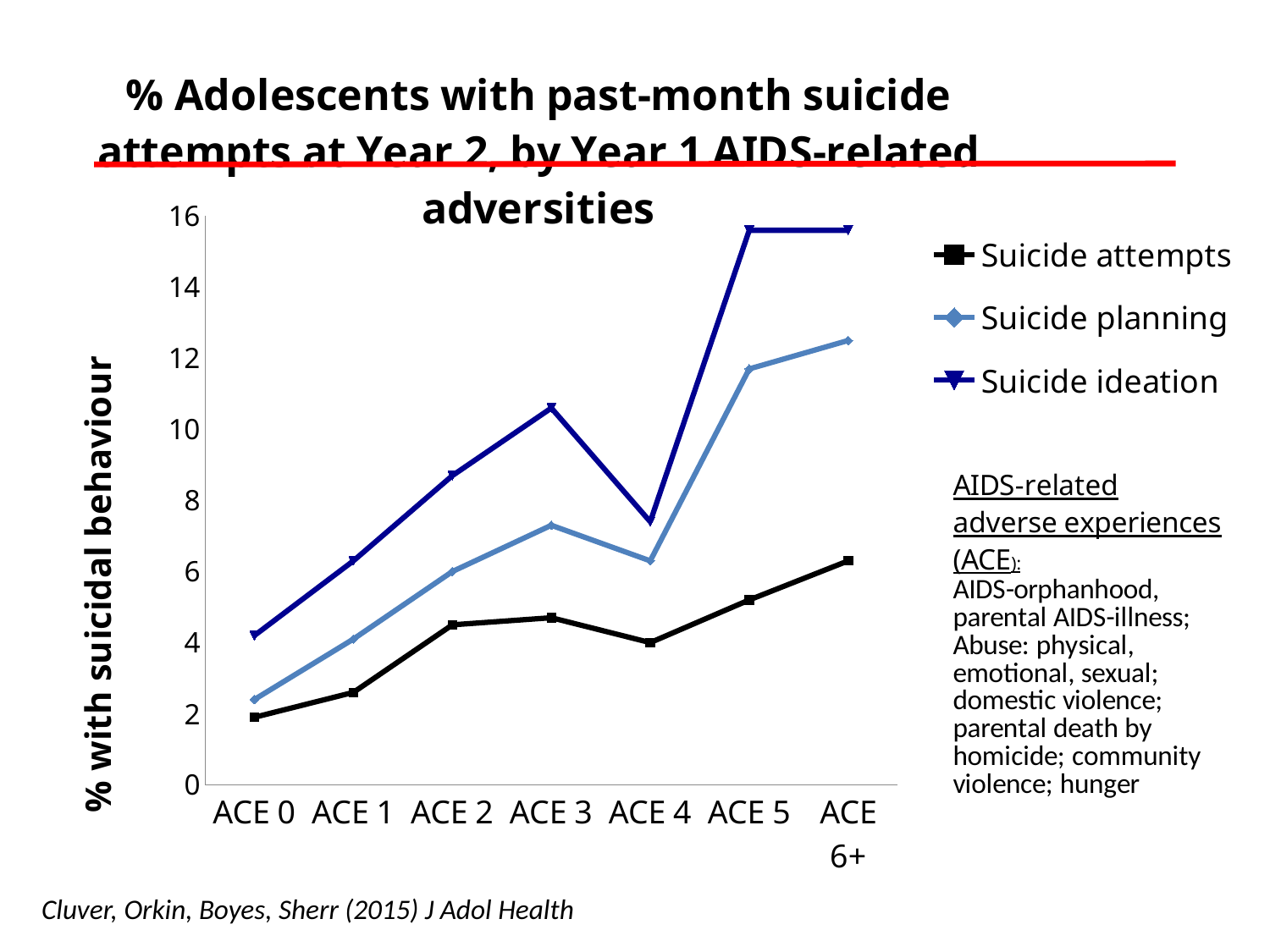
For which ACE category is the Suicide attempts value highest? ACE 6+ Which series is drawn in black with square markers? Suicide attempts Is the Suicide planning value for ACE 0 greater or less than 4? less Is the Suicide ideation value for ACE 5 greater or less than 14? greater How many series does the legend list? 3 Is the Suicide attempts value for ACE 6+ greater or less than 4? greater At ACE 3, which is larger: Suicide ideation or Suicide planning? Suicide ideation For which ACE category is the Suicide ideation value lowest? ACE 0 How many ACE categories are shown on the x axis? 7 Do the Suicide ideation values rise or fall from ACE 3 to ACE 4? fall What kind of chart is shown on the slide? Line chart What is the label of the y axis? % with suicidal behaviour